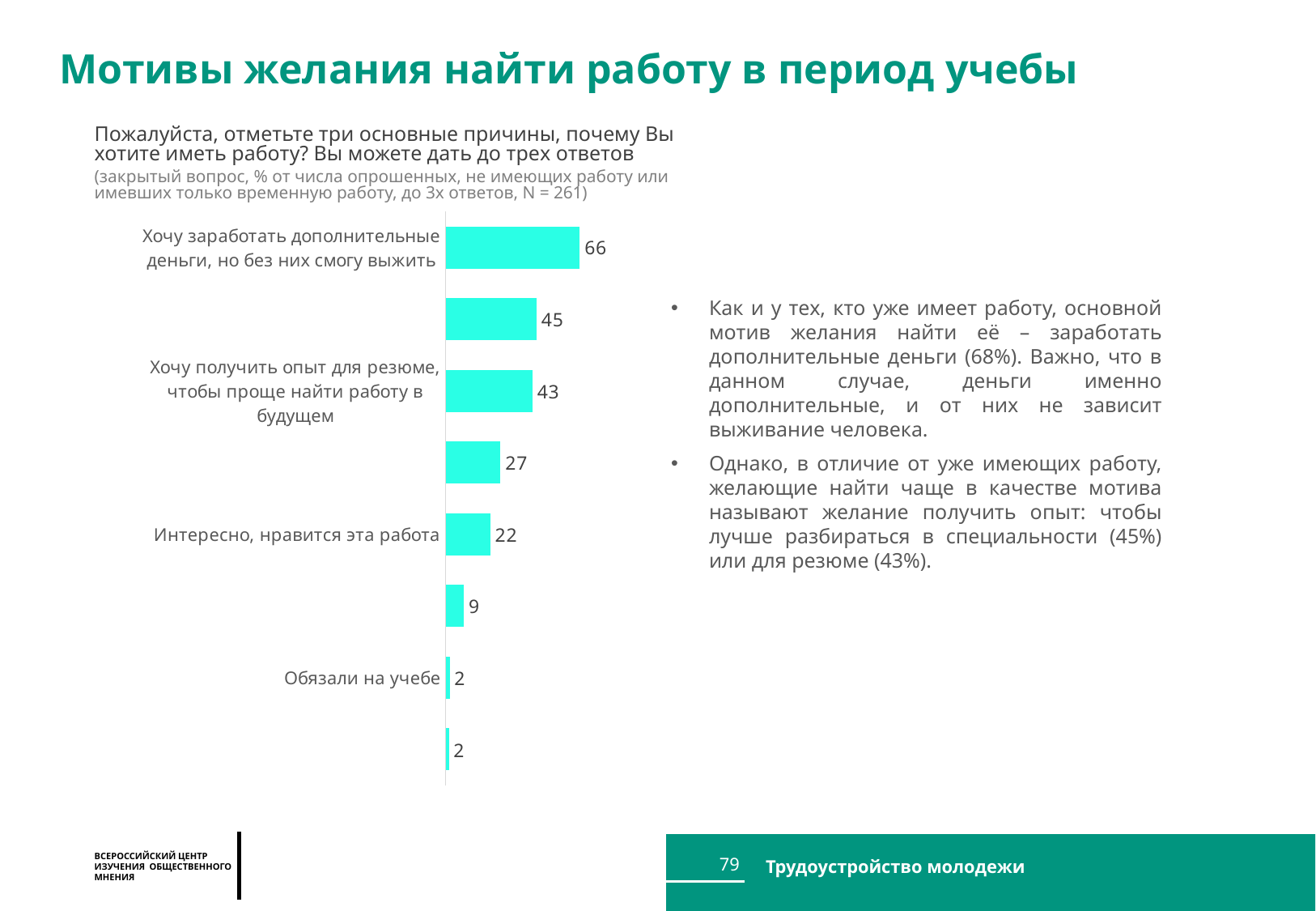
Which is larger: the value for "Интересно, нравится эта работа" or the value for "Обязали на учебе"? Интересно, нравится эта работа What is the highest value shown in the chart? 66 How many bars are plotted in the chart? 8 Which category has the highest value in the chart? Хочу заработать дополнительные деньги, но без них смогу выжить What value is shown for "Интересно, нравится эта работа"? 22 What kind of chart is shown on the slide? Bar chart What is the title of the slide? Мотивы желания найти работу в период учебы What value is shown for "Хочу получить опыт для резюме, чтобы проще найти работу в будущем"? 43 What value is shown for "Обязали на учебе"? 2 What value is shown for "Хочу заработать дополнительные деньги, но без них смогу выжить"? 66 What is the difference between the values for "Хочу заработать дополнительные деньги, но без них смогу выжить" and "Хочу получить опыт для резюме, чтобы проще найти работу в будущем"? 23 What is the difference between the values for "Хочу получить опыт для резюме, чтобы проще найти работу в будущем" and "Интересно, нравится эта работа"? 21